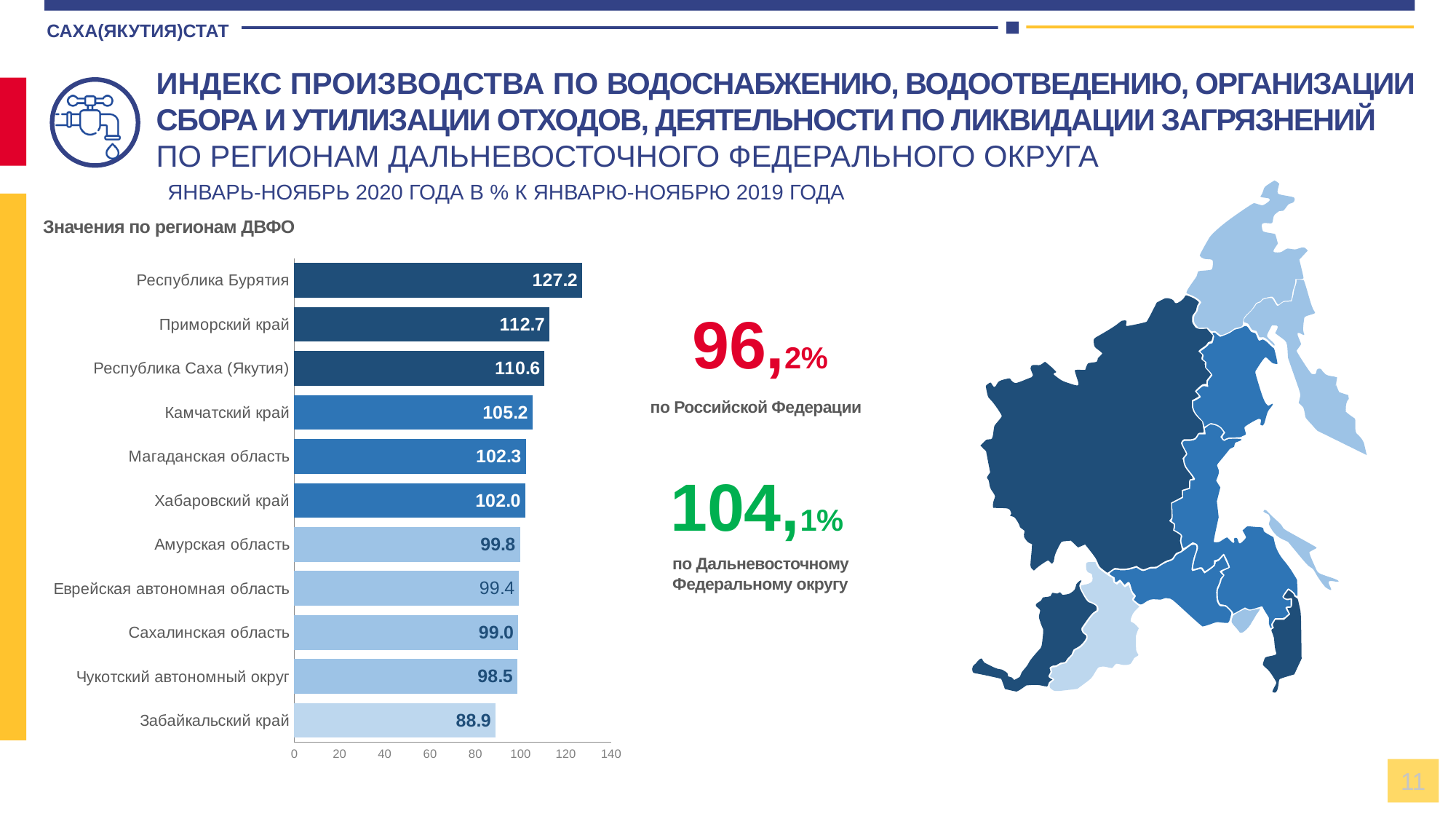
Which region has the highest value in the bar chart? Республика Бурятия What is the value for Камчатский край in the bar chart? 105.2 What kind of chart is shown on the slide? bar chart What is the value for Республика Саха (Якутия) in the bar chart? 110.6 Which is larger, the value for Магаданская область or the value for Сахалинская область? Магаданская область What is the difference between the values for Амурская область and Забайкальский край? 10.9 What is the value for Чукотский автономный округ in the bar chart? 98.5 What value is shown on the slide for the Российская Федерация as a whole? 96,2% What is the difference between the values for Республика Бурятия and Приморский край? 14.5 How many regions are shown in the bar chart? 11 Which region has the lowest value in the bar chart? Забайкальский край Is the value for Приморский край greater or less than 100? greater